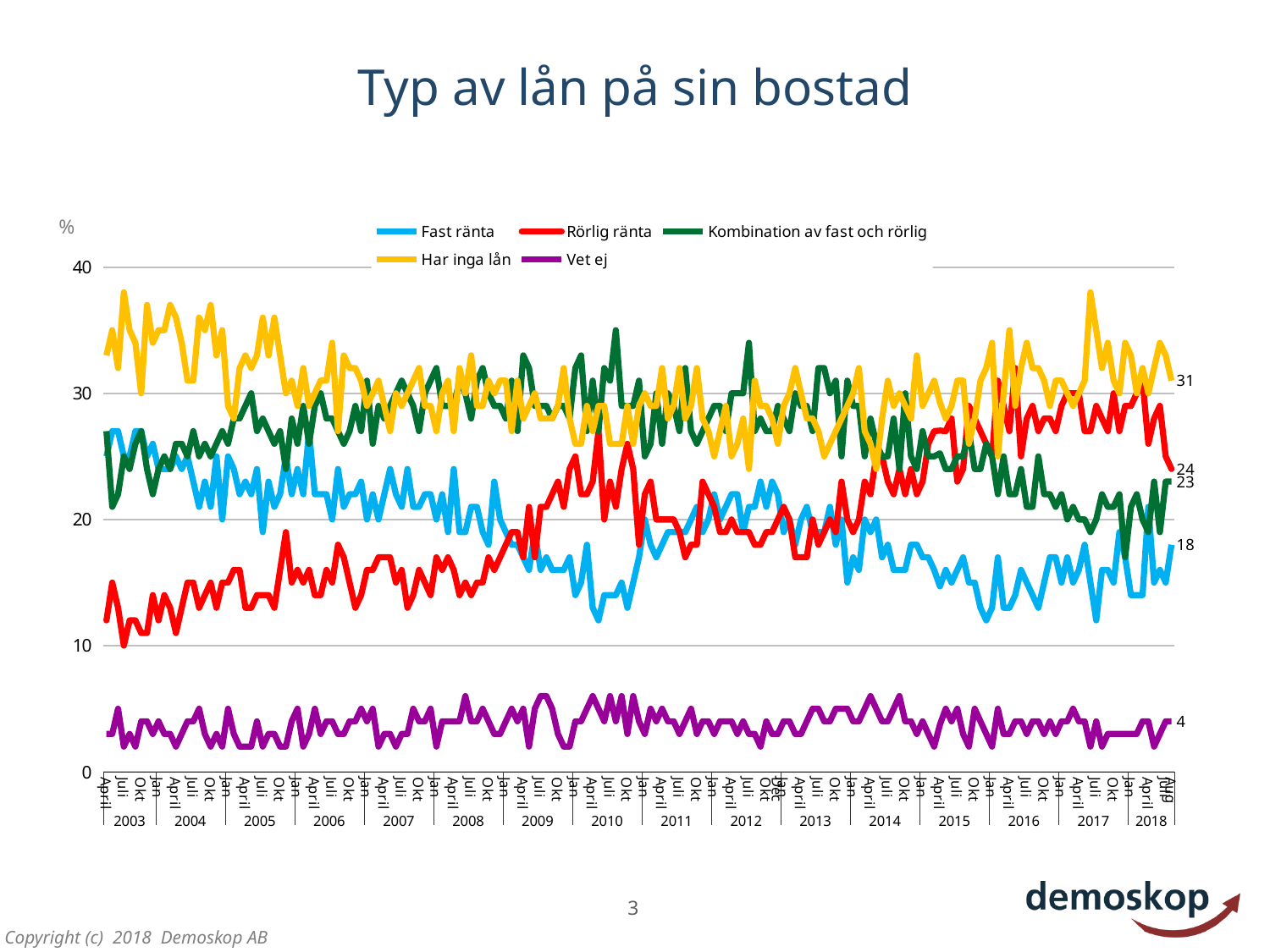
What kind of chart is shown on the slide? Line chart What is the final value shown for Rörlig ränta at the end of the series in 2018? 24 Is the value for Vet ej in 2010 greater or less than 10? less How many series does the legend list? 5 What is the final value shown for Vet ej at the end of the series in 2018? 4 What is the final value shown for Fast ränta at the end of the series in 2018? 18 What is the title of the chart? Typ av lån på sin bostad Does the Fast ränta line rise or fall overall from 2003 to 2018? Fall Which series has the lowest value at the end of the chart in 2018? Vet ej Which series has the highest value at the end of the chart in 2018? Har inga lån What is the difference between the final values of Har inga lån and Rörlig ränta in 2018? 7 What is the final value shown for Har inga lån at the end of the series in 2018? 31